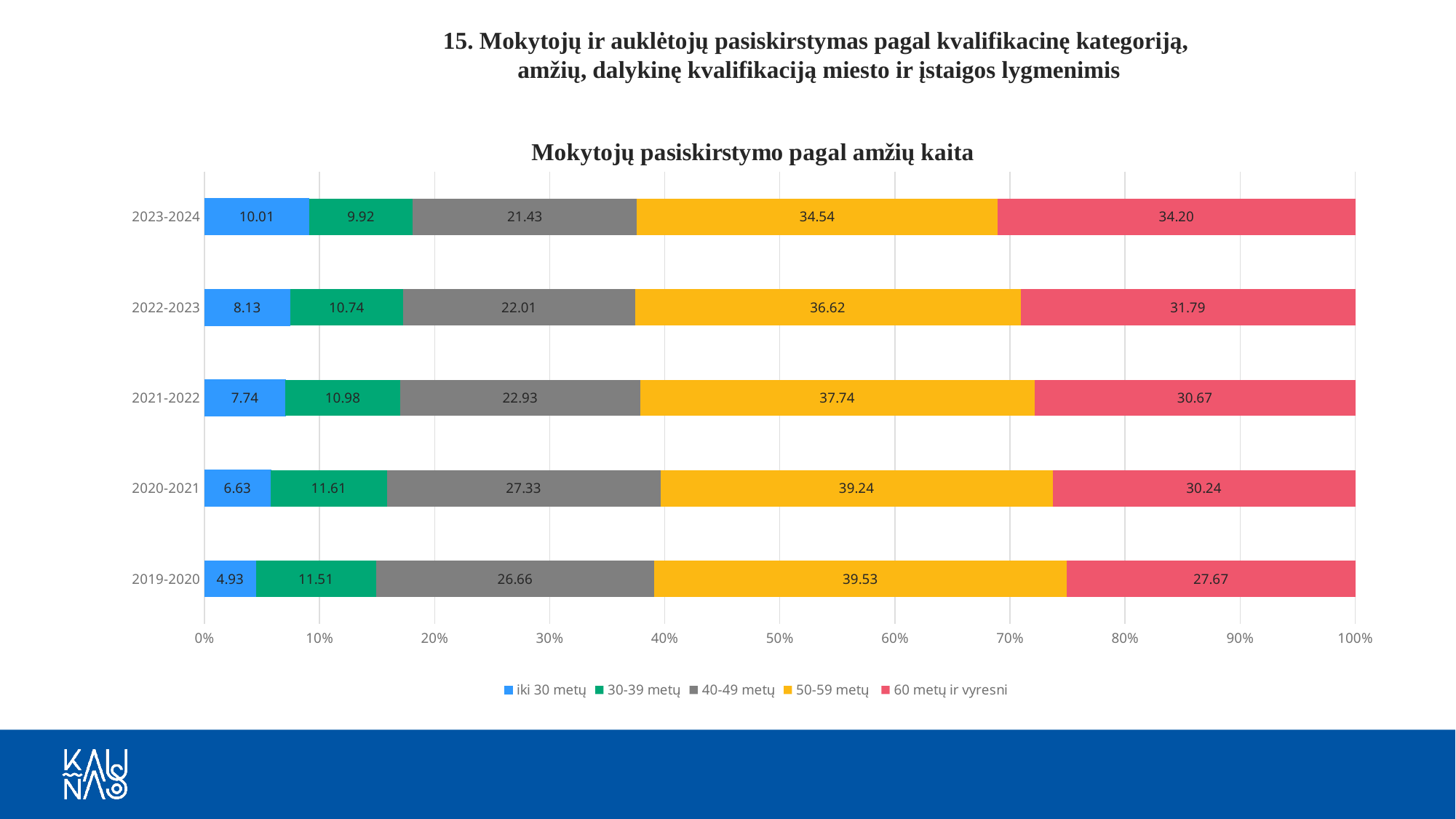
How many series does the legend list? 5 What is the difference between the "50-59 metų" and "60 metų ir vyresni" values in 2023-2024? 0.34 What is the value for "40-49 metų" in 2020-2021? 27.33 Which is larger: the "30-39 metų" value in 2021-2022 or in 2022-2023? 2021-2022 How many school years are shown on the chart? 5 Does the value for "iki 30 metų" rise or fall from 2019-2020 to 2023-2024? Rises What is the value for "iki 30 metų" in 2023-2024? 10.01 In which school year is the value for "60 metų ir vyresni" highest? 2023-2024 What kind of chart is shown on the slide? Stacked bar chart What is the difference between the "40-49 metų" values in 2020-2021 and 2023-2024? 5.90 What is the value for "50-59 metų" in 2019-2020? 39.53 In which school year is the value for "iki 30 metų" lowest? 2019-2020